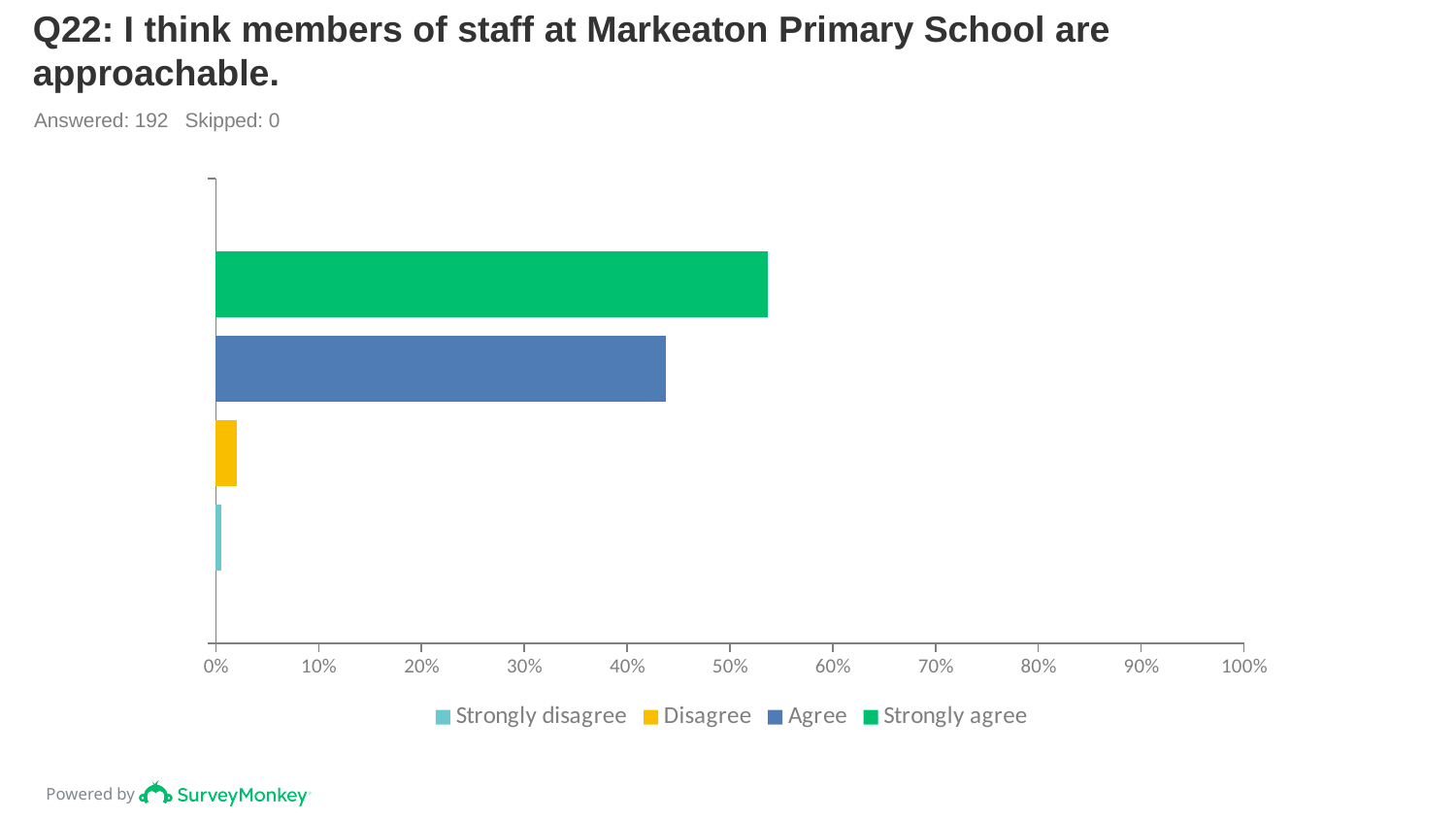
Which response category has the highest value? Strongly agree How many bars are plotted in the chart? 4 Is the value for Agree greater or less than 50%? less Which response category has the lowest value? Strongly disagree What kind of chart is shown on the slide? bar chart What colour is used for the Strongly agree series in the legend? green Is the value for Strongly agree greater or less than 50%? greater Is the value for Agree greater or less than 40%? greater Which is larger, the value for Strongly agree or the value for Agree? Strongly agree Which is larger, the value for Disagree or the value for Strongly disagree? Disagree How many series does the legend list? 4